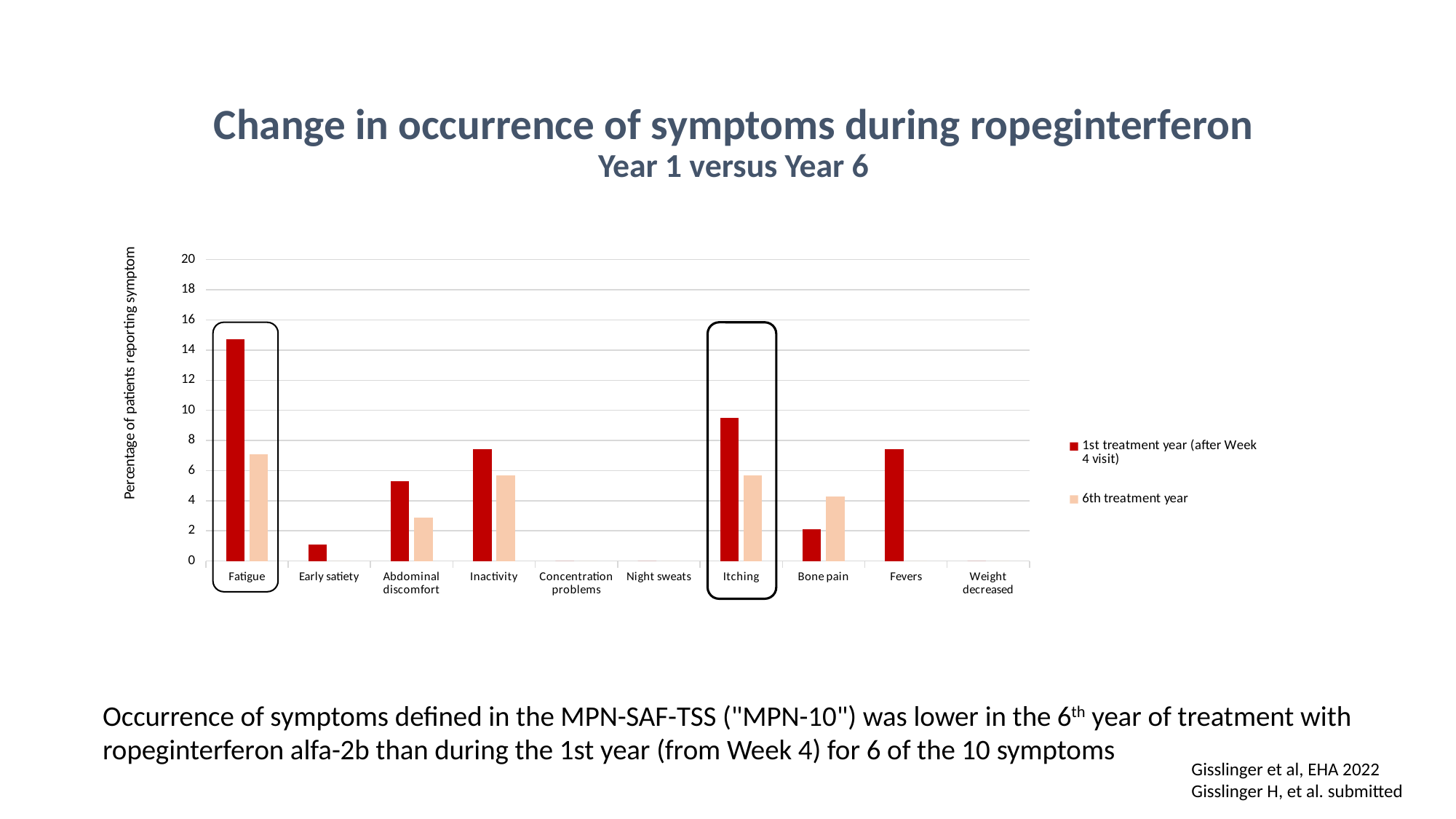
For Bone pain, which is larger: the 1st treatment year value or the 6th treatment year value? 6th treatment year For Fatigue, which is larger: the 1st treatment year value or the 6th treatment year value? 1st treatment year Which symptom has the highest percentage of patients reporting it in the 6th treatment year? Fatigue What is the label of the chart's y axis? Percentage of patients reporting symptom What kind of chart is shown on the slide? bar chart Is the 6th treatment year value for Abdominal discomfort greater or less than 4? less Which symptom has the highest percentage of patients reporting it in the 1st treatment year? Fatigue Is the 1st treatment year value for Fevers greater or less than 6? greater How many symptom categories are shown on the x axis of the chart? 10 Is the 1st treatment year value for Itching greater or less than 8? greater How many series does the chart's legend list? 2